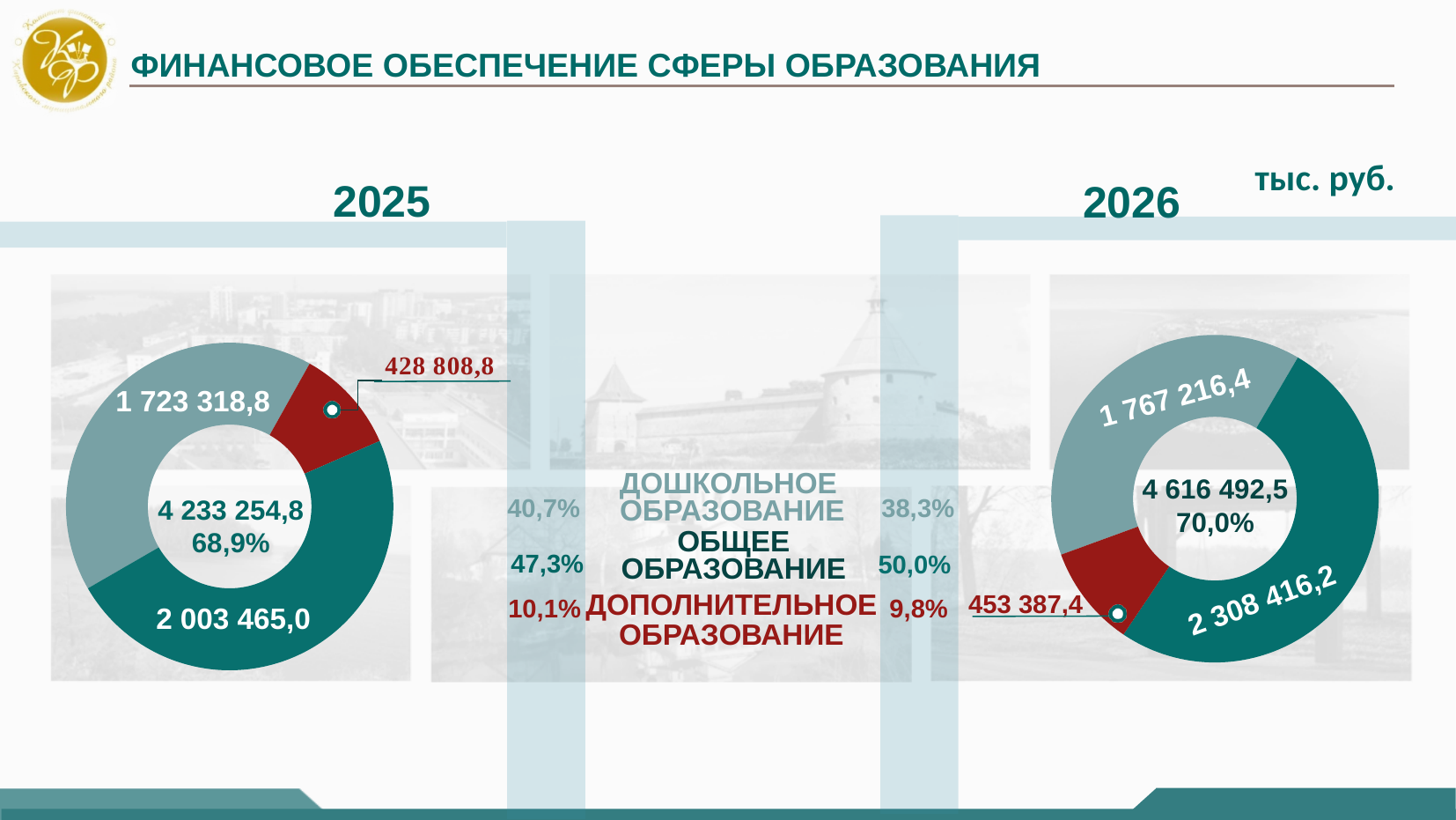
What share of the 2025 chart does Дополнительное образование represent? 10,1% What is the difference between Дополнительное образование in 2026 and in 2025? 24 578,6 In the 2025 chart, which category has the largest value? Общее образование In the 2026 chart, what is the value for Общее образование? 2 308 416,2 In the 2026 chart, what is the value for Дополнительное образование? 453 387,4 Which is larger: Дошкольное образование in 2025 or Дошкольное образование in 2026? 2026 How many categories does each donut chart show? 3 In the 2026 chart, which category has the smallest value? Дополнительное образование In the 2025 chart, what is the value for Дошкольное образование? 1 723 318,8 What type of chart is used for 2025 and 2026? Donut (pie) chart What share of the 2026 chart does Общее образование represent? 50,0% In the 2025 chart, what is the value for Общее образование? 2 003 465,0